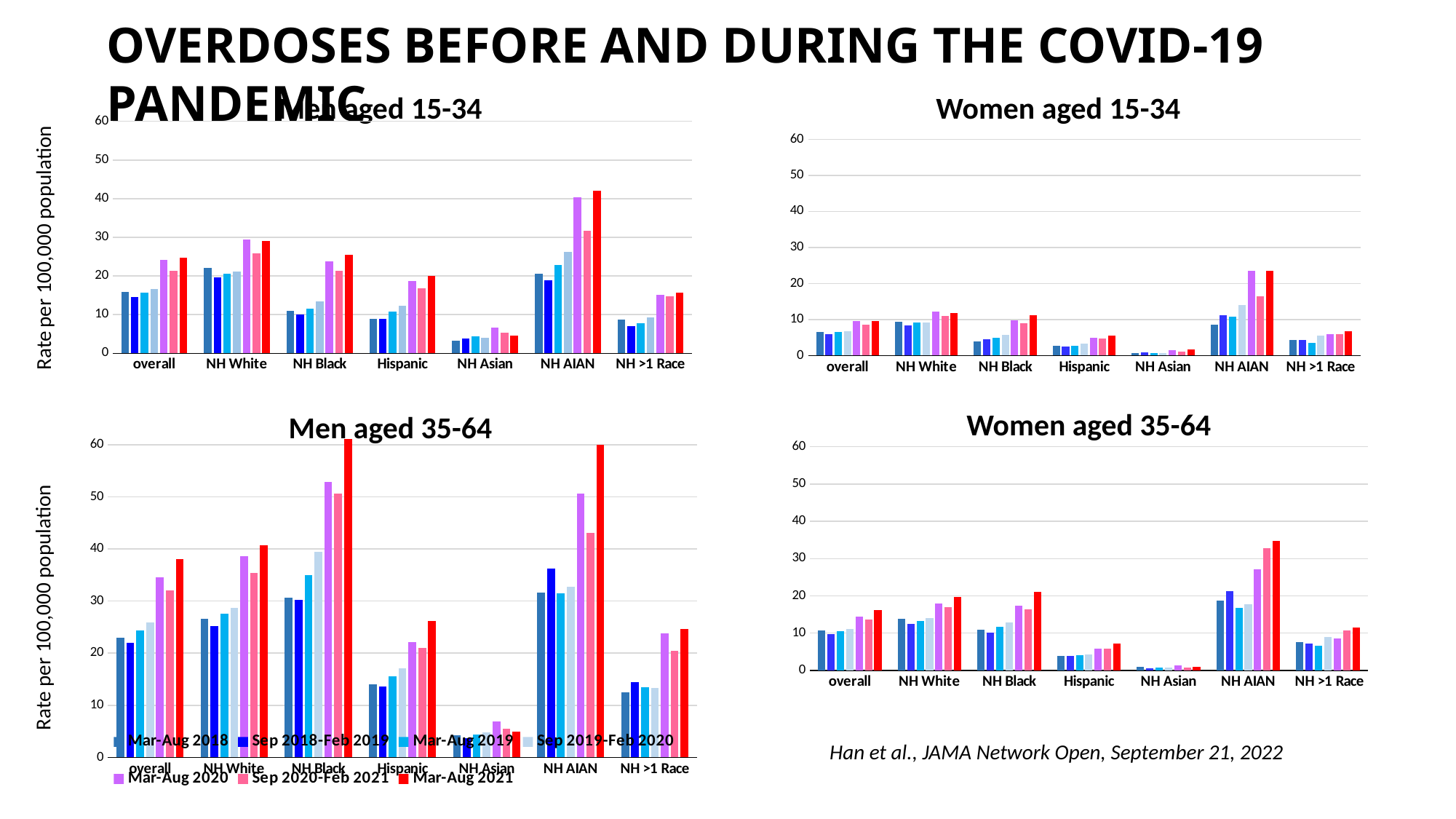
In the Men aged 35-64 chart, which category has the tallest bar? NH Black In the Men aged 15-34 chart, is the Mar-Aug 2021 value for NH AIAN greater or less than 40? greater In the Women aged 35-64 chart, is the Mar-Aug 2021 value for NH AIAN greater or less than 30? greater What kind of chart is the Men aged 15-34 chart? bar chart How many charts are shown on the slide? 4 In the Women aged 35-64 chart, which category has the highest bars? NH AIAN What is the y-axis label on the Men aged 35-64 chart? Rate per 100,000 population In the Men aged 35-64 chart, is the Mar-Aug 2021 value for NH Black greater or less than 50? greater In the Women aged 15-34 chart, which category has the lowest bars? NH Asian In the Women aged 35-64 chart, which is larger for Mar-Aug 2021: overall or NH White? NH White How many series does the legend list? 7 How many race/ethnicity categories are shown on the x axis of the Women aged 35-64 chart? 7